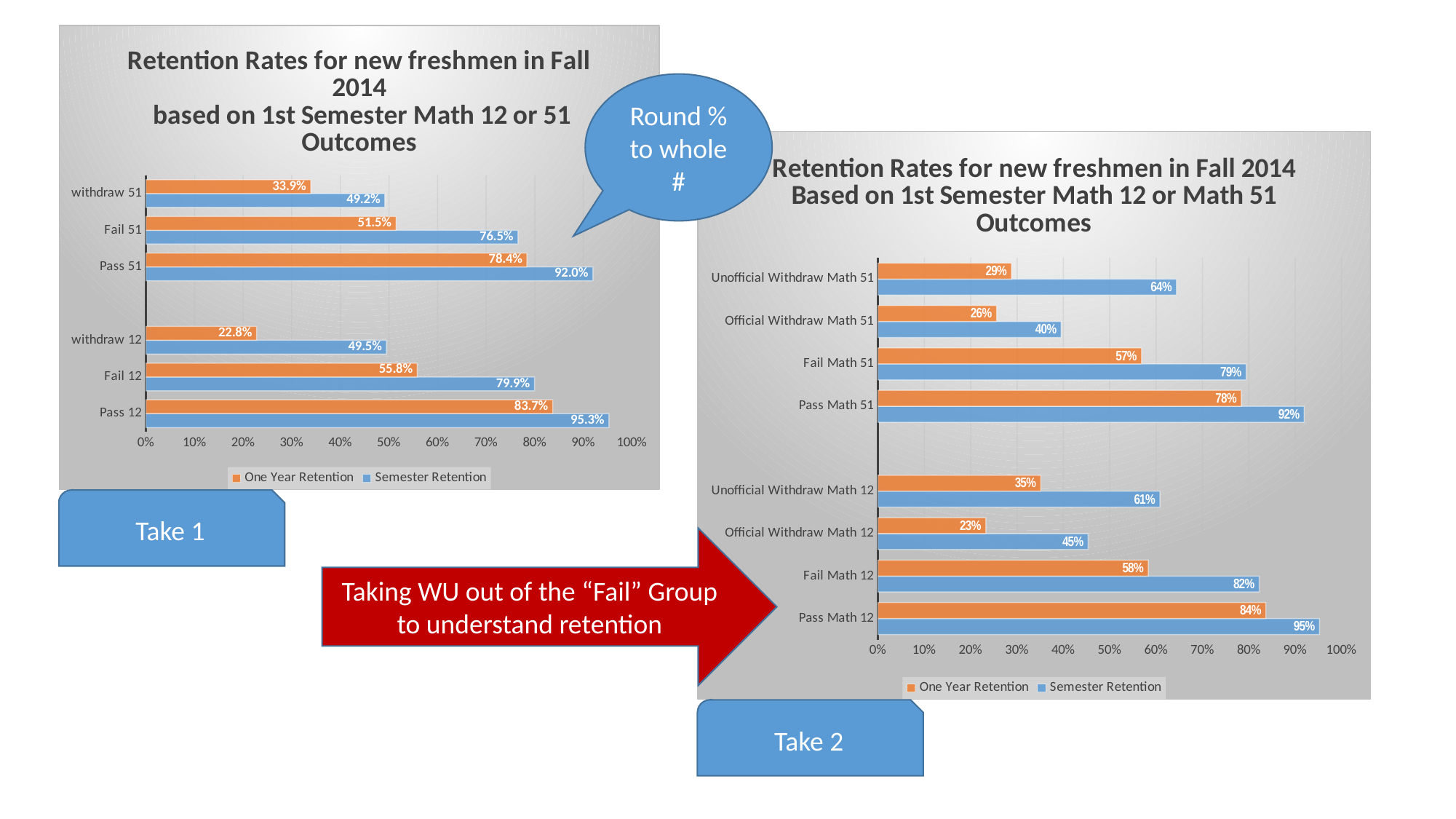
In the right chart (Take 2), how many categories are shown on the vertical axis? 8 What type of chart is the left chart (Take 1)? Bar chart In the left chart (Take 1), how many series does the legend list? 2 In the right chart (Take 2), what is the Semester Retention value for Unofficial Withdraw Math 51? 64% In the right chart (Take 2), which category has the highest Semester Retention? Pass Math 12 In the right chart (Take 2), which is larger: the One Year Retention for Fail Math 12 or for Fail Math 51? Fail Math 12 In the right chart (Take 2), what is the difference between the Semester Retention and One Year Retention values for Official Withdraw Math 51? 14% In the right chart (Take 2), what is the One Year Retention value for Official Withdraw Math 12? 23% In the left chart (Take 1), what is the One Year Retention value for Pass 12? 83.7% In the left chart (Take 1), what is the difference between the Semester Retention and One Year Retention values for Pass 51? 13.6% In the left chart (Take 1), which category has the lowest One Year Retention? withdraw 12 In the left chart (Take 1), what is the Semester Retention value for Fail 51? 76.5%